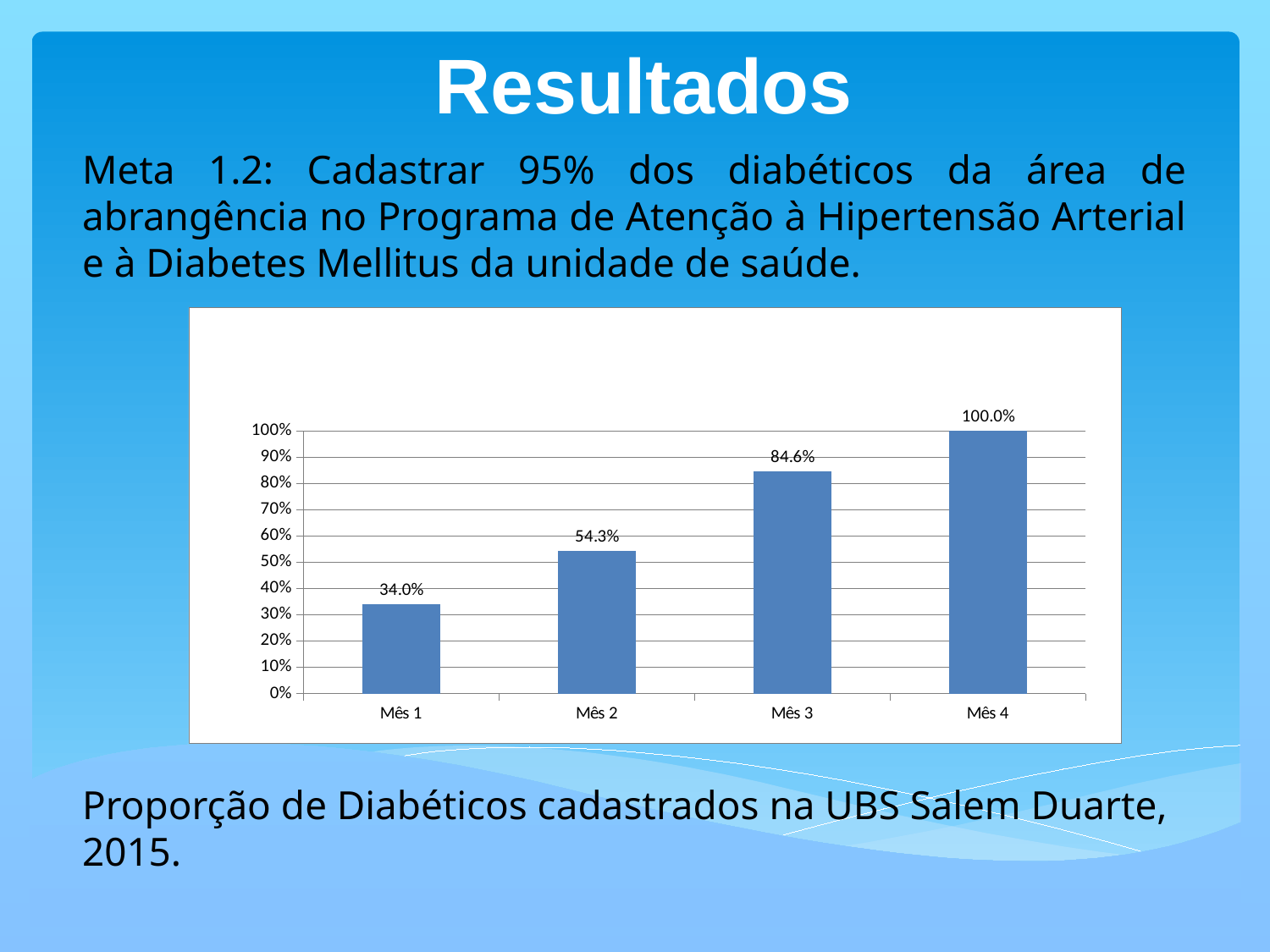
What is the value for Mês 4? 100.0% What kind of chart is shown on the slide? bar chart Which month has the lowest value? Mês 1 What is the difference between the values for Mês 3 and Mês 2? 30.3% What is the value for Mês 1? 34.0% Is the value for Mês 1 greater or less than 40%? less Which month has the highest value? Mês 4 What is the value for Mês 2? 54.3% What is the value for Mês 3? 84.6% Which is larger, the value for Mês 2 or the value for Mês 3? Mês 3 Do the values rise or fall from Mês 1 to Mês 4? rise How many months are shown on the x axis? 4